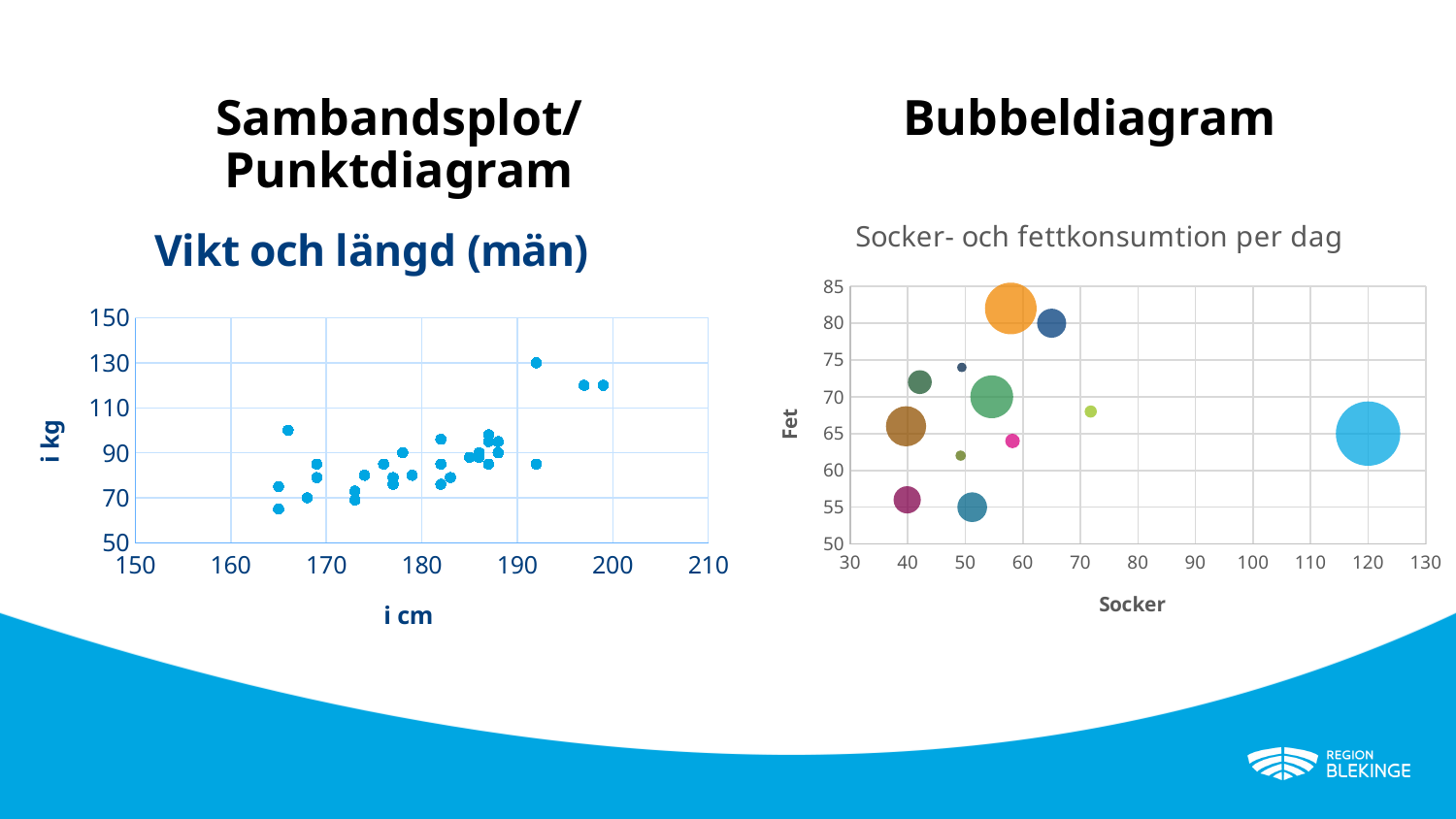
In the right chart "Socker- och fettkonsumtion per dag", is the Fet value of the orange bubble greater or less than 80? greater In the right chart "Socker- och fettkonsumtion per dag", how many bubbles are plotted? 12 What kind of chart is the left chart titled "Vikt och längd (män)"? Scatter plot In the right chart "Socker- och fettkonsumtion per dag", which bubble has the higher Socker value: the light blue bubble or the orange bubble? The light blue bubble In the left chart "Vikt och längd (män)", is the weight of the highest point greater or less than 110 kg? greater In the left chart "Vikt och längd (män)", what is the label of the y axis? i kg What kind of chart is the right chart titled "Socker- och fettkonsumtion per dag"? Bubble chart In the left chart "Vikt och längd (män)", is the weight of the lowest point greater or less than 70 kg? less In the left chart "Vikt och längd (män)", what is the label of the x axis? i cm In the right chart "Socker- och fettkonsumtion per dag", what is the label of the y axis? Fet In the left chart "Vikt och längd (män)", do the weight values generally rise or fall as height increases along the x axis? Rise